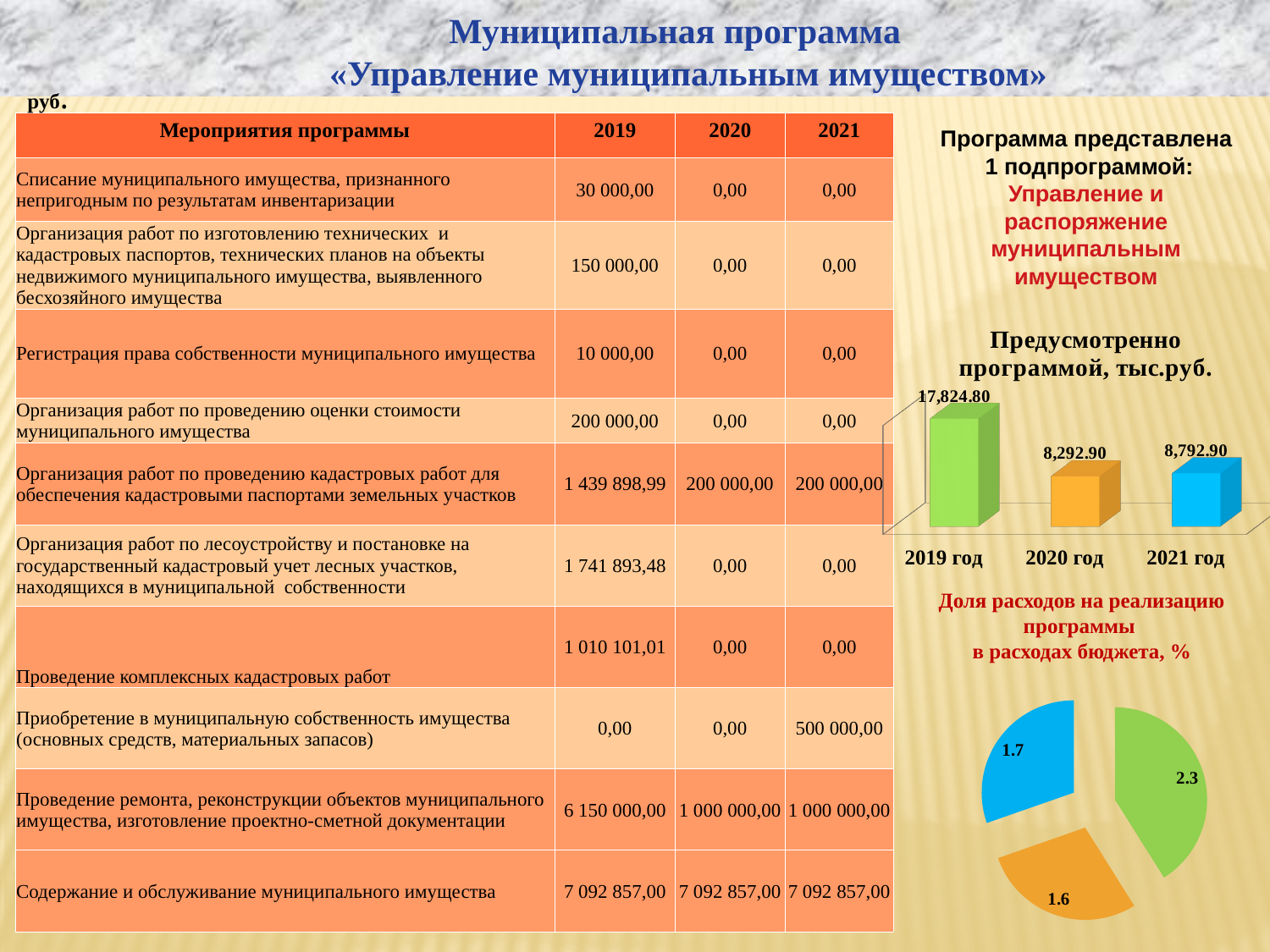
In the bar chart 'Предусмотренно программой, тыс.руб.', which year has the highest value? 2019 год In the bar chart 'Предусмотренно программой, тыс.руб.', what is the value for 2019 год? 17,824.80 What kind of chart is 'Доля расходов на реализацию программы в расходах бюджета, %'? pie chart In the bar chart 'Предусмотренно программой, тыс.руб.', which is larger, the value for 2020 год or 2021 год? 2021 год In the bar chart 'Предусмотренно программой, тыс.руб.', what is the difference between the values for 2021 год and 2020 год? 500.00 In the pie chart 'Доля расходов на реализацию программы в расходах бюджета, %', what is the value of the largest slice? 2.3 In the bar chart 'Предусмотренно программой, тыс.руб.', what is the value for 2020 год? 8,292.90 In the bar chart 'Предусмотренно программой, тыс.руб.', what is the difference between the values for 2019 год and 2020 год? 9,531.90 How many bars are shown in the bar chart 'Предусмотренно программой, тыс.руб.'? 3 What kind of chart is 'Предусмотренно программой, тыс.руб.'? bar chart In the bar chart 'Предусмотренно программой, тыс.руб.', which year has the lowest value? 2020 год In the bar chart 'Предусмотренно программой, тыс.руб.', what is the value for 2021 год? 8,792.90